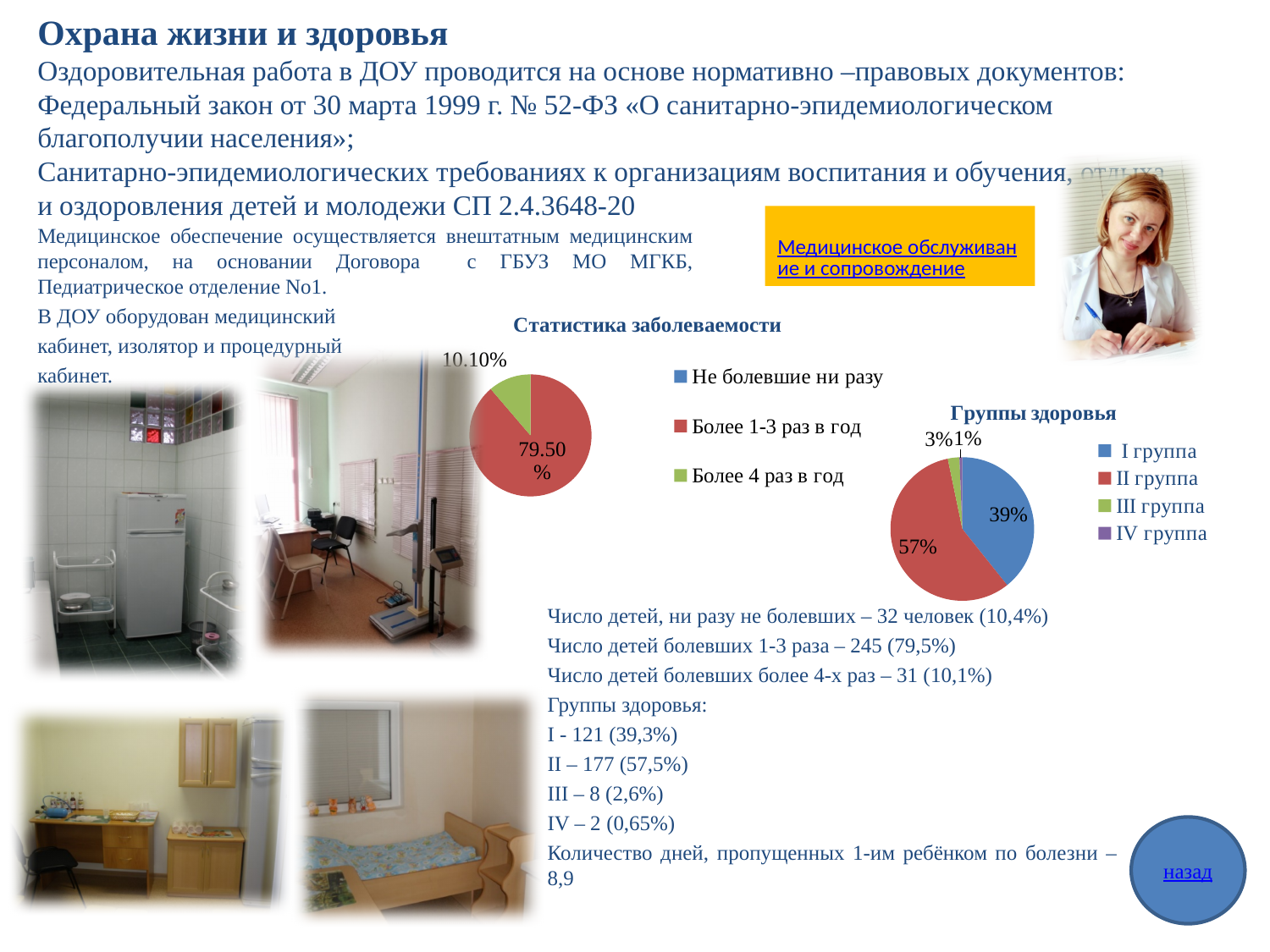
On the 'Группы здоровья' chart, what share is shown for IV группа? 1% On the 'Группы здоровья' chart, what share is shown for II группа? 57% On the 'Группы здоровья' chart, how many entries does the legend list? 4 On the 'Группы здоровья' chart, which group has the smallest share? IV группа On the 'Группы здоровья' chart, what share is shown for III группа? 3% What type of chart is the 'Статистика заболеваемости' chart? Pie chart On the 'Группы здоровья' chart, which group has the largest share? II группа On the 'Группы здоровья' chart, what share is shown for I группа? 39% On the 'Статистика заболеваемости' chart, which is larger: 'Более 1-3 раз в год' or 'Более 4 раз в год'? Более 1-3 раз в год On the 'Статистика заболеваемости' chart, what share is shown for 'Более 1-3 раз в год'? 79.50% On the 'Статистика заболеваемости' chart, what share is shown for 'Более 4 раз в год'? 10.10% On the 'Группы здоровья' chart, how many percentage points larger is II группа than I группа? 18